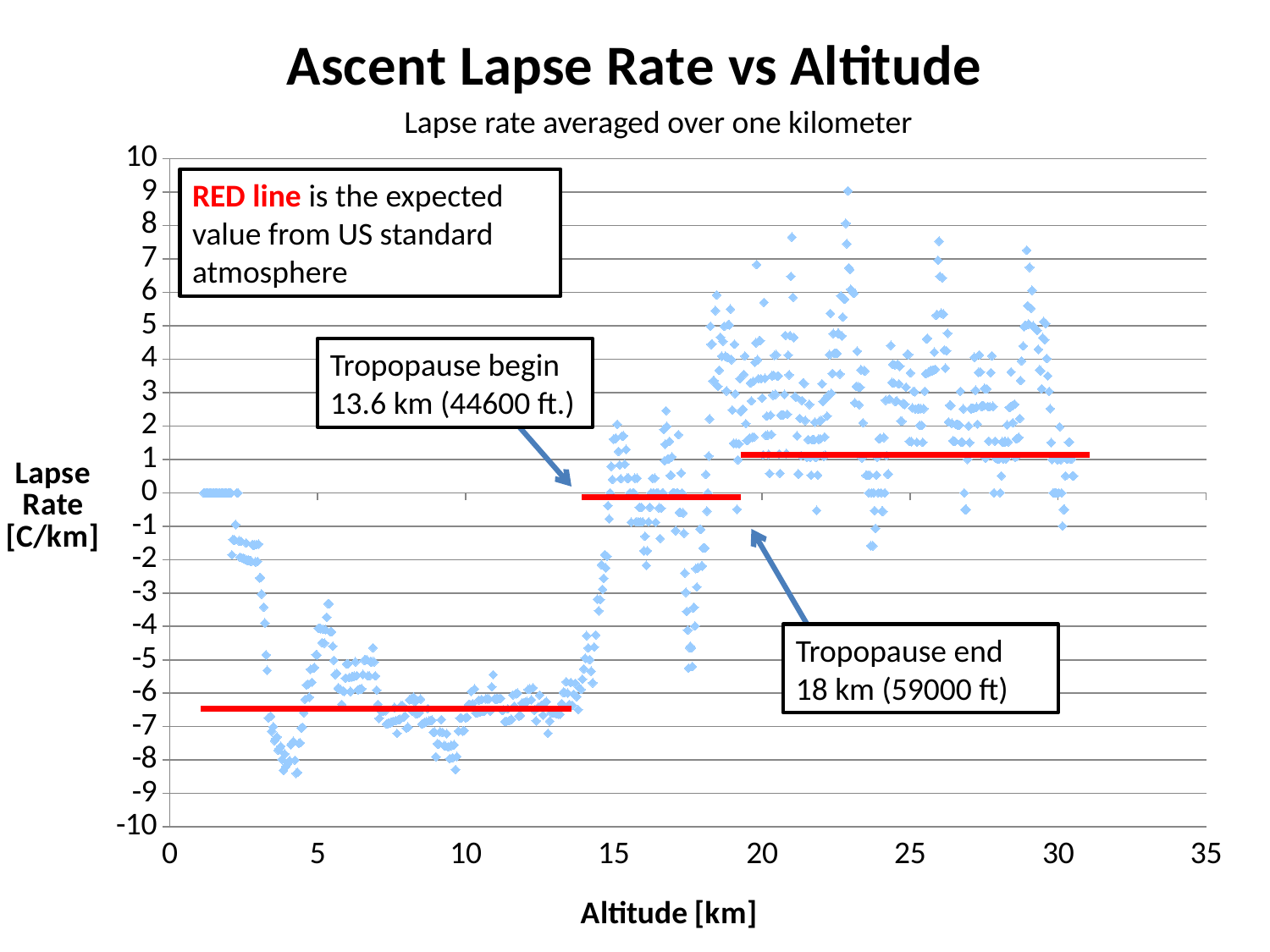
What kind of chart is shown on the slide? scatter chart Do the lapse rate values rise or fall as altitude increases from 10 km to 20 km? rise Is the lapse rate at an altitude of 4 km greater or less than -5? less Is the red line between 20 km and 30 km greater or less than 0? greater Is the lapse rate at an altitude of 10 km greater or less than 0? less According to the annotation, what does the red line represent? the expected value from US standard atmosphere What is the title of the chart? Ascent Lapse Rate vs Altitude At what altitude does the tropopause begin, according to the annotation? 13.6 km (44600 ft.) At what altitude does the tropopause end, according to the annotation? 18 km (59000 ft) Which has the larger lapse rate: the points at 10 km or the points at 25 km? 25 km